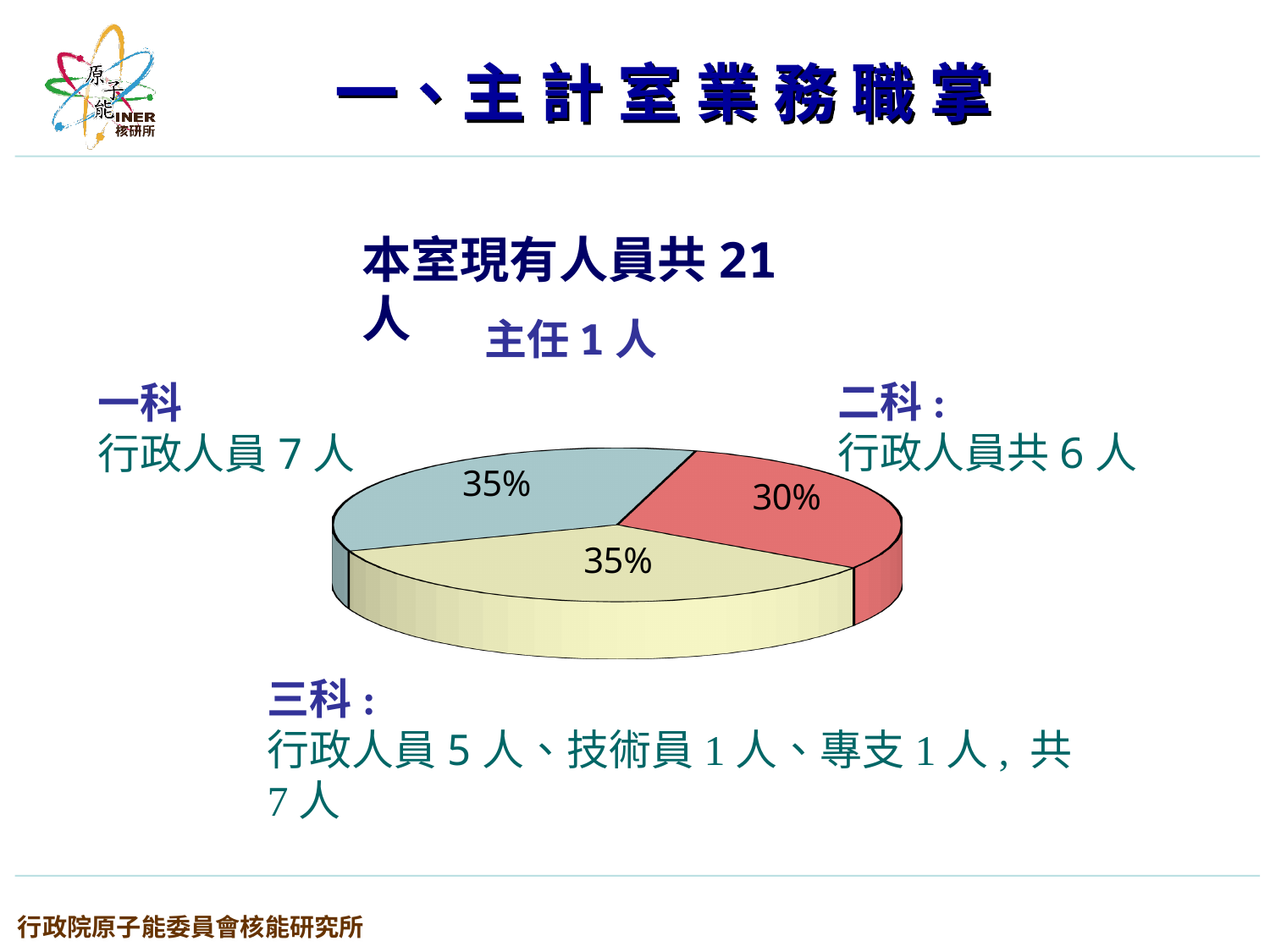
What kind of chart is shown on the slide? pie chart What colour is the slice labelled 30%? red According to the text above the chart, how many people are in the office in total (本室現有人員共)? 21 人 How many slices does the pie chart have? 3 Is the red slice larger or smaller than the yellow slice? smaller What percentage is shown on the blue-grey slice at the upper left of the pie chart? 35% What do the three percentages on the pie chart add up to? 100% Which slice of the pie chart has the smallest percentage? the red slice (30%) What percentage is shown on the yellow slice at the bottom of the pie chart? 35% What is the difference in percentage points between the yellow slice and the red slice? 5 What percentage is shown on the red slice of the pie chart? 30% How many slices of the pie chart are labelled 35%? 2